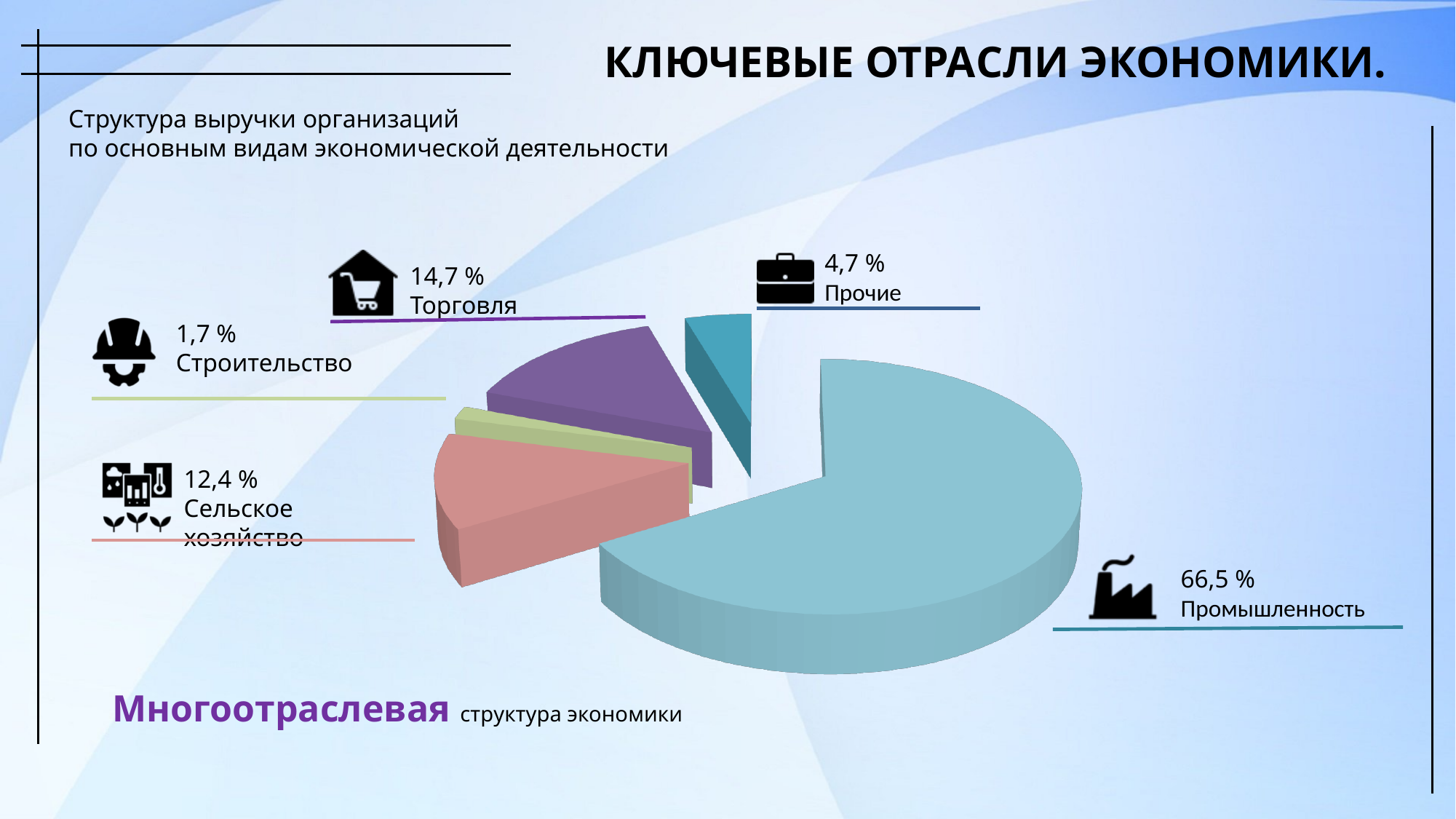
Which has a larger share, Прочие or Строительство? Прочие What share of revenue does Строительство account for? 1,7 % Which sector has the smallest share of revenue? Строительство What share of revenue does Сельское хозяйство account for? 12,4 % What share of revenue does Торговля account for? 14,7 % What share of revenue does Прочие account for? 4,7 % What share of revenue does Промышленность account for? 66,5 % Which sector has the largest share of revenue? Промышленность What is the subtitle describing the chart? Структура выручки организаций по основным видам экономической деятельности What kind of chart is shown on the slide? Pie chart What is the difference between the shares of Торговля and Сельское хозяйство? 2,3 % How many sectors are shown in the pie chart? 5